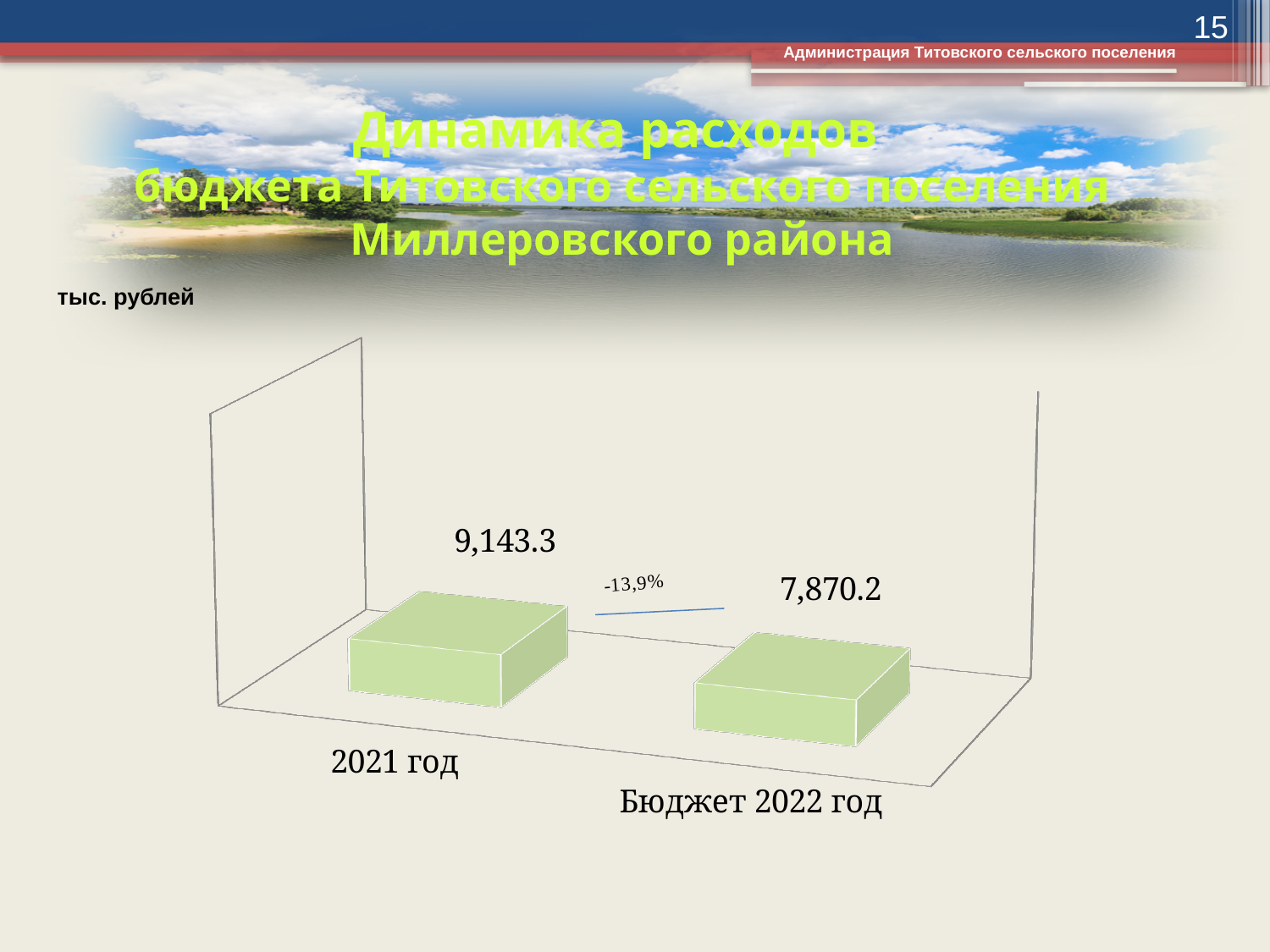
In what units are the chart values given, according to the label above the chart? тыс. рублей What percentage change is annotated between the two bars? -13,9% Which is larger, the value for 2021 год or the value for Бюджет 2022 год? 2021 год Which category has the lowest value? Бюджет 2022 год What is the value for 2021 год? 9,143.3 Do the values rise or fall from 2021 год to Бюджет 2022 год? fall What is the difference between the value for 2021 год and the value for Бюджет 2022 год? 1,273.1 Which category has the highest value? 2021 год What is the value for Бюджет 2022 год? 7,870.2 What kind of chart is shown on the slide? bar chart How many categories are shown in the chart? 2